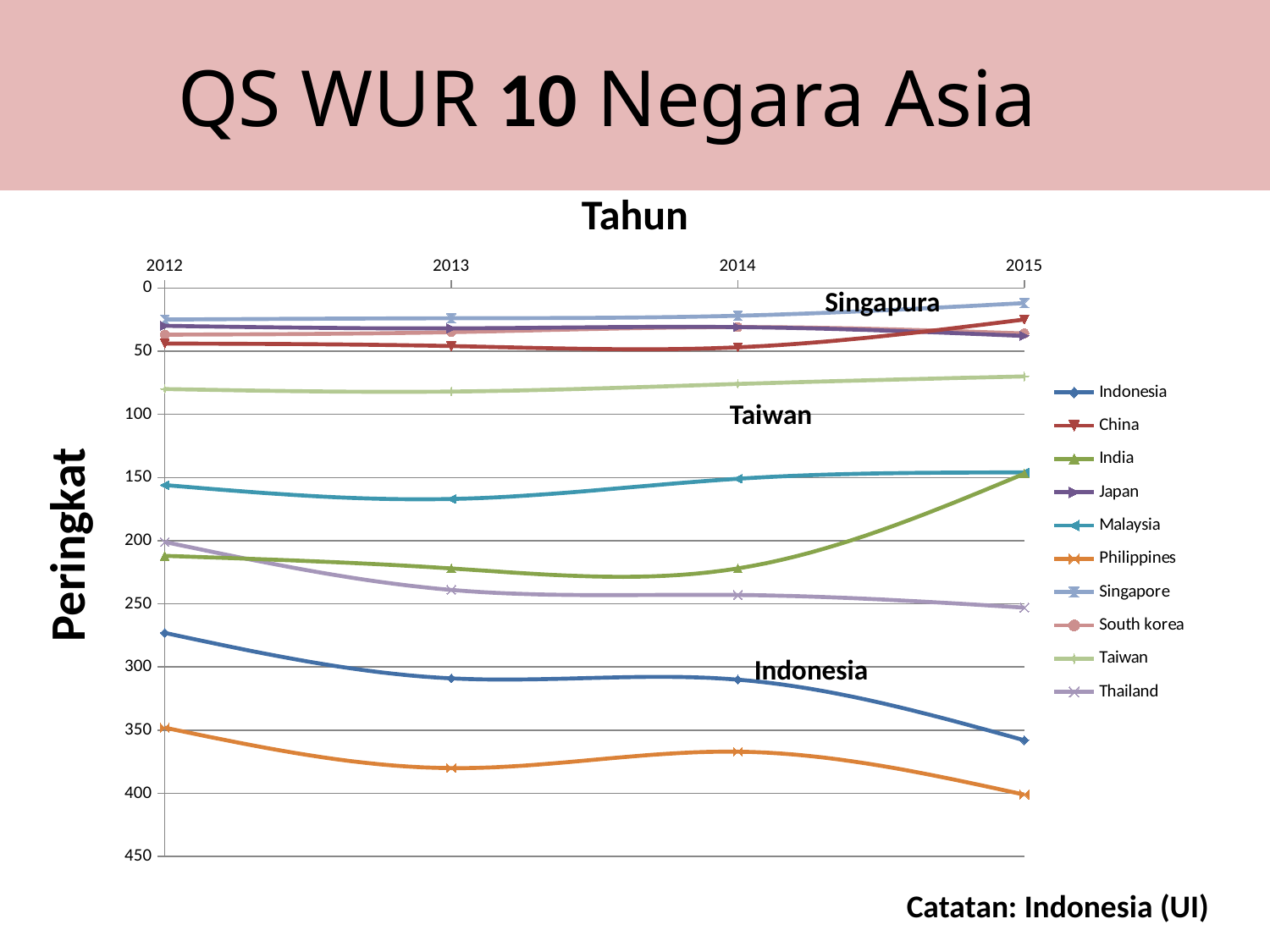
What is the title of the vertical axis? Peringkat How many years are shown along the x axis? 4 Which series has the highest value in 2015? Philippines Is the value for Taiwan in 2015 greater or less than 100? less How many series does the legend list? 10 What kind of chart is shown on the slide? line chart Is the value for India in 2015 greater or less than 200? less Is the value for Indonesia in 2012 greater or less than 300? less Which series has the lowest value in 2015? Singapore In 2014, which has the larger value, Philippines or Indonesia? Philippines